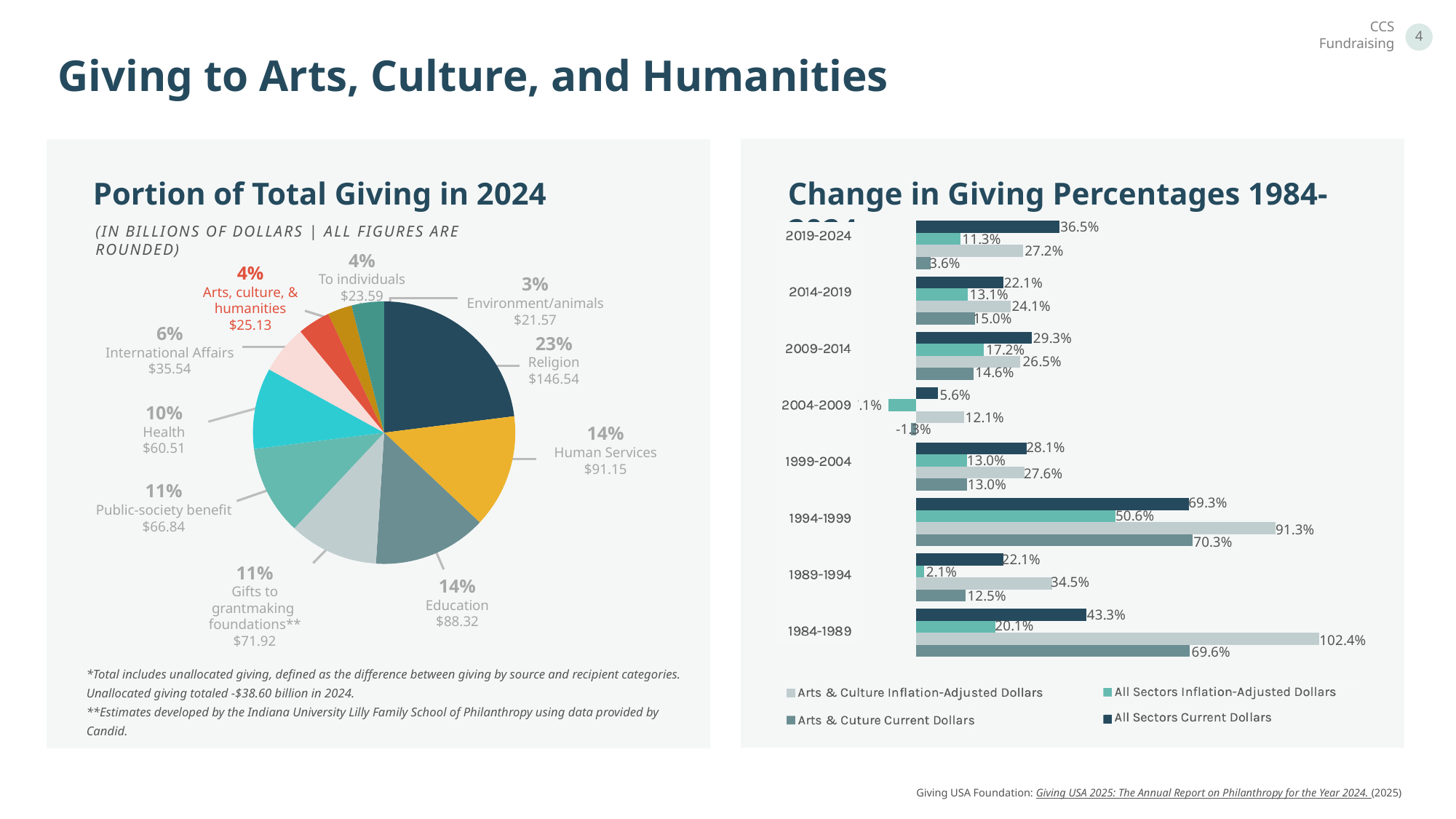
In the 'Portion of Total Giving in 2024' chart, which category has the largest share? Religion In the 'Portion of Total Giving in 2024' chart, which category has the smallest share? Environment/animals In the 'Change in Giving Percentages 1984-2024' chart, which is larger for 1994-1999: Arts & Culture Inflation-Adjusted Dollars or All Sectors Inflation-Adjusted Dollars? Arts & Culture Inflation-Adjusted Dollars In the 'Change in Giving Percentages 1984-2024' chart, what is the Arts & Culture Inflation-Adjusted Dollars value for 1984-1989? 102.4% In the 'Change in Giving Percentages 1984-2024' chart, how many series does the legend list? 4 In the 'Portion of Total Giving in 2024' chart, what dollar amount is shown for Religion? $146.54 In the 'Portion of Total Giving in 2024' chart, what percentage share does Arts, culture, & humanities have? 4% In the 'Portion of Total Giving in 2024' chart, what is the difference in dollars between Human Services and Education? $2.83 What type of chart is 'Portion of Total Giving in 2024'? Pie chart In the 'Portion of Total Giving in 2024' chart, how many slices does the pie have? 10 In the 'Change in Giving Percentages 1984-2024' chart, what is the All Sectors Current Dollars value for 2019-2024? 36.5% What type of chart is 'Change in Giving Percentages 1984-2024'? Bar chart